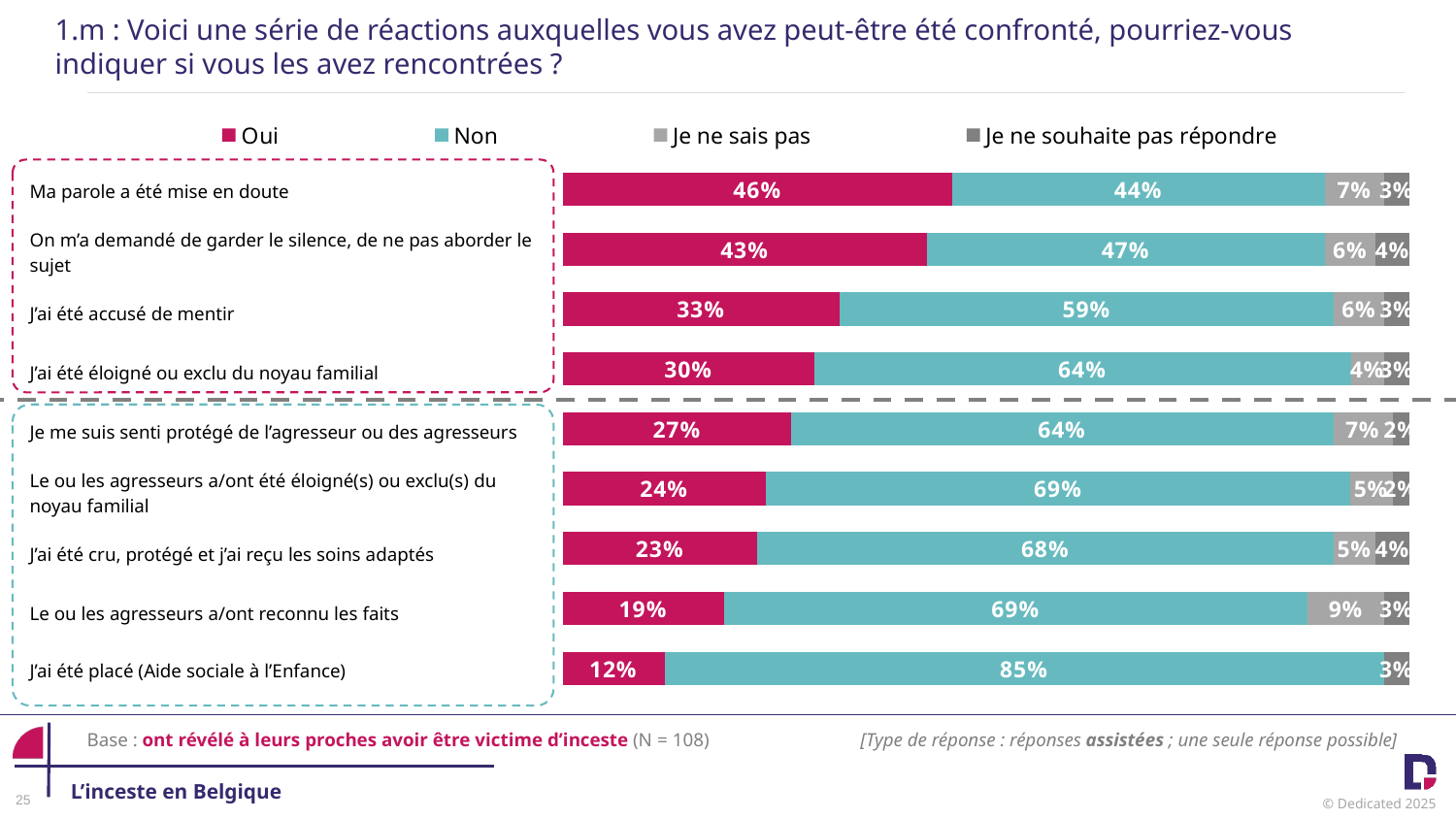
Which category has the highest 'Oui' value? Ma parole a été mise en doute Which is larger: the 'Oui' value for 'J'ai été cru, protégé et j'ai reçu les soins adaptés' or for 'Le ou les agresseurs a/ont été éloigné(s) ou exclu(s) du noyau familial'? Le ou les agresseurs a/ont été éloigné(s) ou exclu(s) du noyau familial How many categories (reactions) are plotted in the chart? 9 How many series does the legend list? 4 What is the 'Non' value for 'J'ai été placé (Aide sociale à l'Enfance)'? 85% What is the 'Je ne sais pas' value for 'Le ou les agresseurs a/ont reconnu les faits'? 9% What is the base (N) indicated below the chart? N = 108 Which category has the lowest 'Oui' value? J'ai été placé (Aide sociale à l'Enfance) What is the 'Je ne souhaite pas répondre' value for 'On m'a demandé de garder le silence, de ne pas aborder le sujet'? 4% What is the difference between the 'Non' values for 'J'ai été accusé de mentir' and 'Ma parole a été mise en doute'? 15% What type of chart is shown on the slide? stacked bar chart What is the 'Oui' value for 'Ma parole a été mise en doute'? 46%